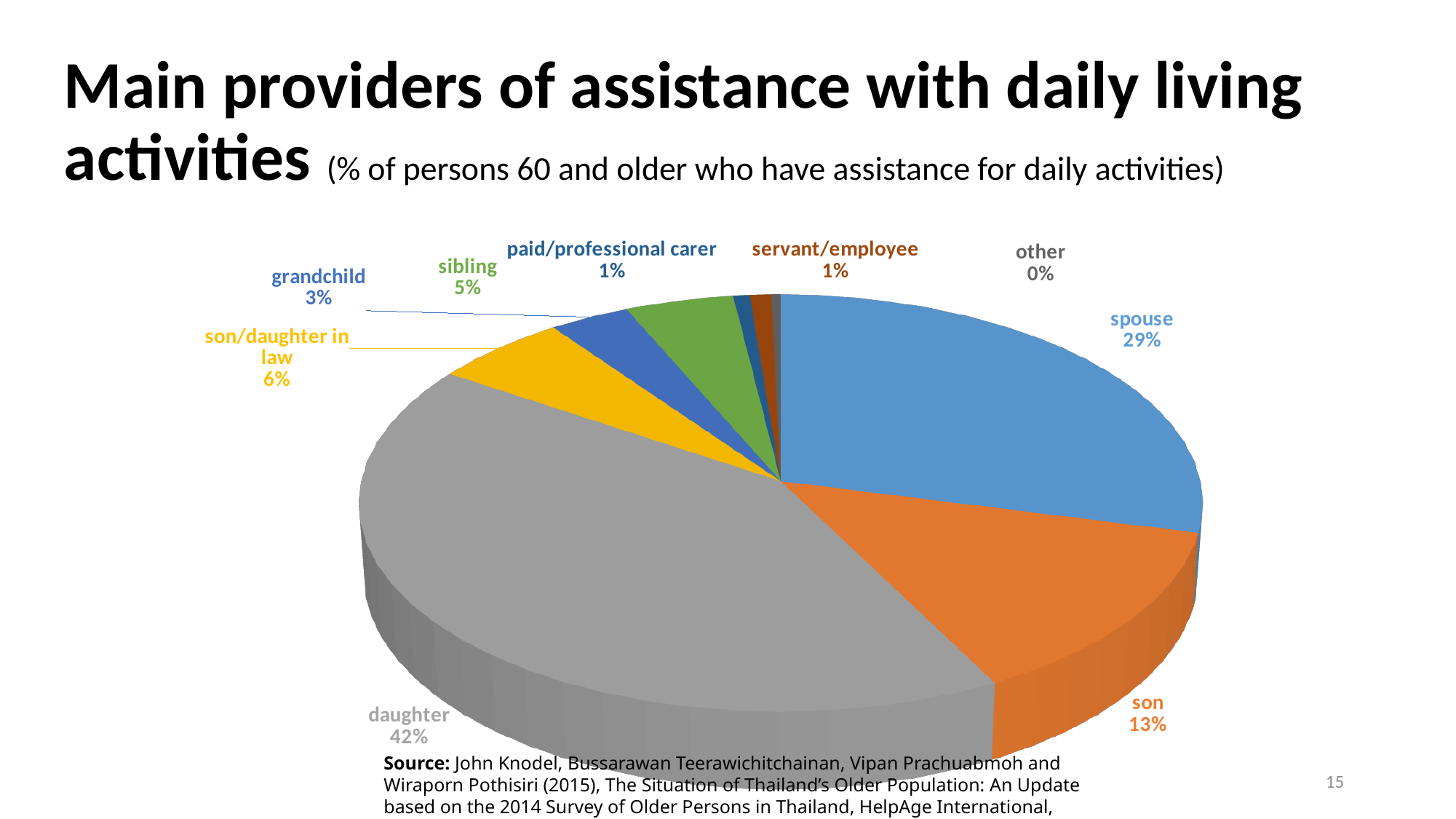
Which slice is larger, son or son/daughter in law? son What share of the pie is labelled for daughter? 42% What share of the pie is labelled for spouse? 29% Which category has the smallest labelled share of the pie? other What share of the pie is labelled for sibling? 5% What share of the pie is labelled for son? 13% How many categories are labelled on the pie chart? 9 What share of the pie is labelled for grandchild? 3% What is the difference in percentage points between the daughter and spouse slices? 13 What kind of chart is shown on the slide? pie chart What share of the pie is labelled for son/daughter in law? 6% Which category has the largest slice of the pie? daughter